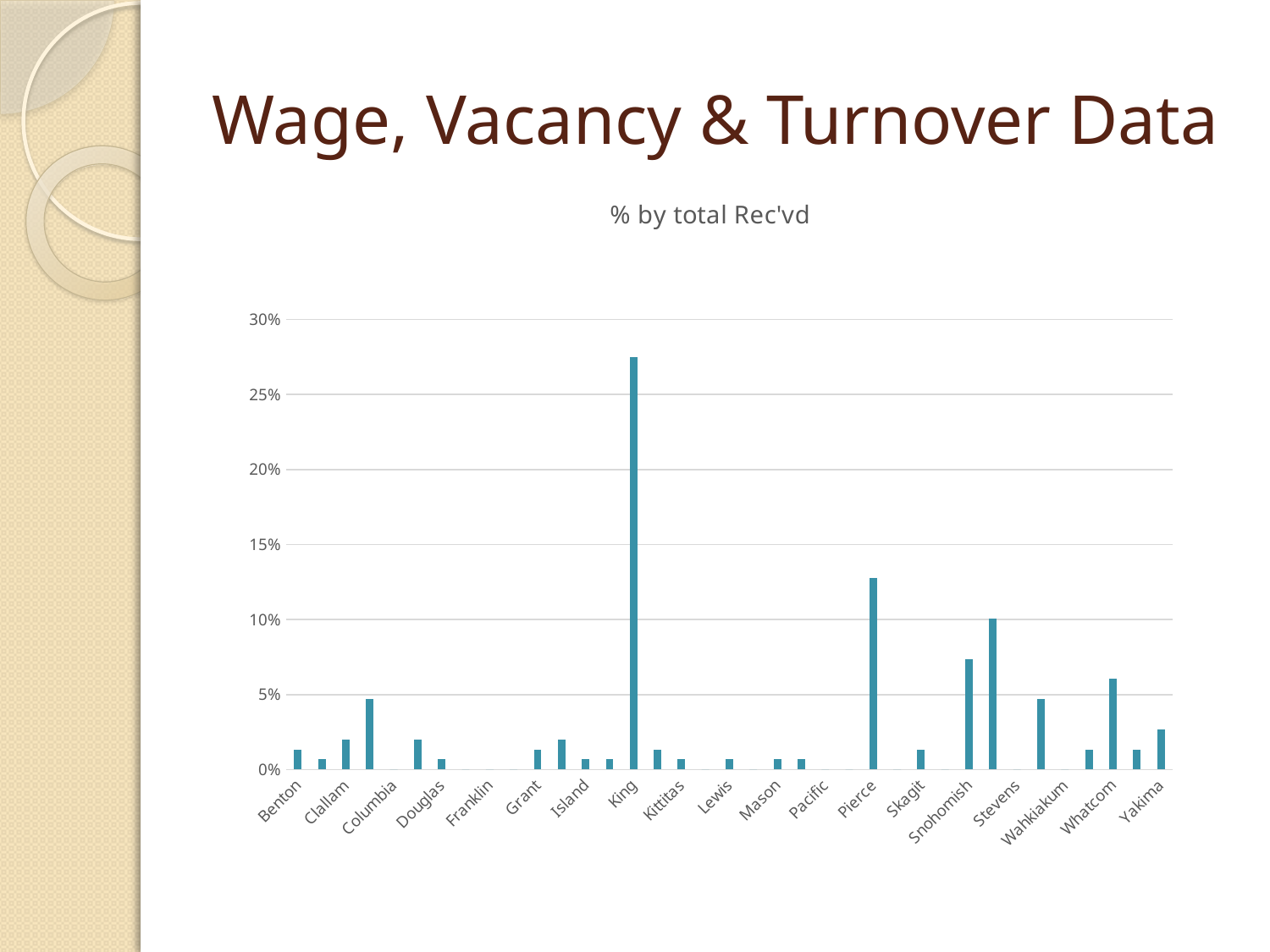
What is the title of the chart? % by total Rec'vd What kind of chart is shown on the slide? bar chart Is the value for Pierce greater or less than 10%? greater Which has a larger value, Pierce or Snohomish? Pierce Which county has the highest value in the chart? King Is the value for Snohomish greater or less than 5%? greater Which has a larger value, Whatcom or Yakima? Whatcom Which has a larger value, King or Pierce? King Is the value for Benton greater or less than 5%? less